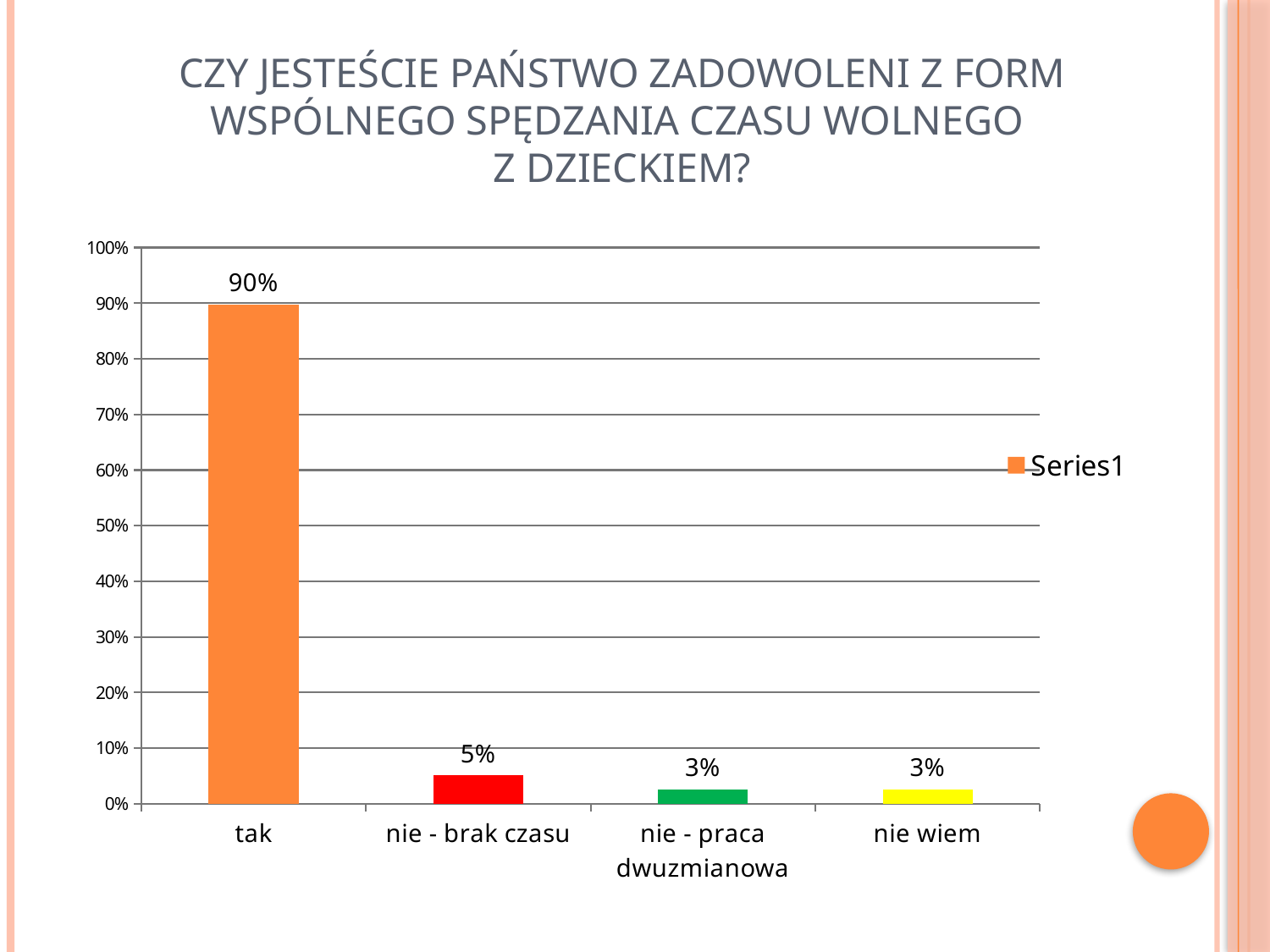
What is the difference between the values for "tak" and "nie - brak czasu"? 85% What is the name of the series listed in the legend? Series1 What kind of chart is shown on the slide? bar chart How many categories are shown on the x axis? 4 Which is larger, the value for "nie - brak czasu" or the value for "nie wiem"? nie - brak czasu How many series does the legend list? 1 Which category has the highest value? tak Is the value for "tak" greater or less than 80%? greater What is the value for "nie - brak czasu"? 5% What is the value for "nie wiem"? 3% What is the value for "tak"? 90% What is the value for "nie - praca dwuzmianowa"? 3%